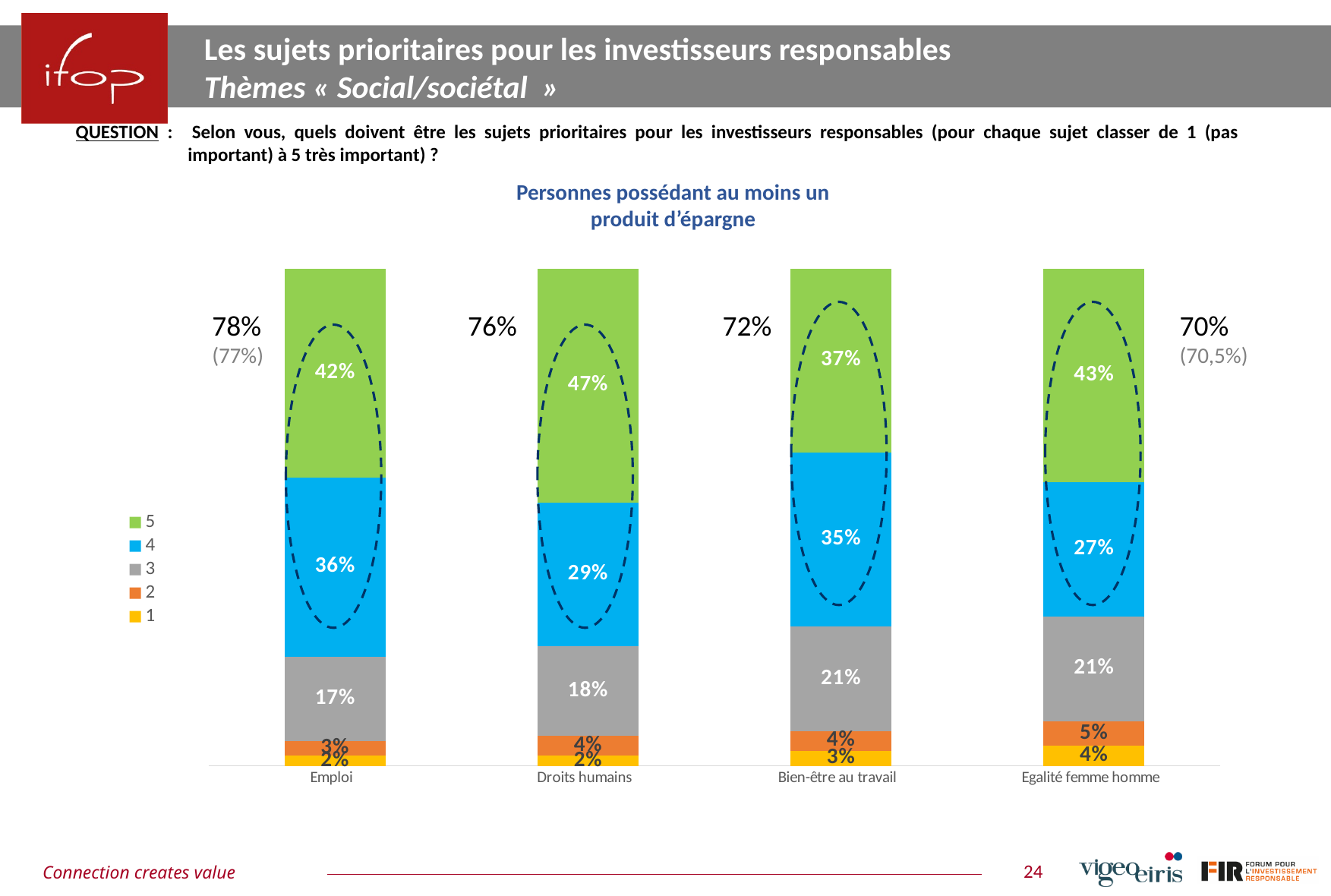
Which is larger: the series 4 value for Emploi or the series 4 value for Droits humains? Emploi What is the value of series 1 for Egalité femme homme? 4% How many series does the legend list? 5 Which category has the highest value for series 5? Droits humains What kind of chart is shown on the slide? Stacked bar chart How many categories are shown on the x axis of the chart? 4 What is the value of series 5 for Droits humains? 47% Which category has the lowest value for series 4? Egalité femme homme What is the difference between the series 5 values for Egalité femme homme and Bien-être au travail? 6% What is the value of series 3 for Emploi? 17% What is the value of series 4 for Bien-être au travail? 35% What is the total of the stacked bar for Emploi? 100%